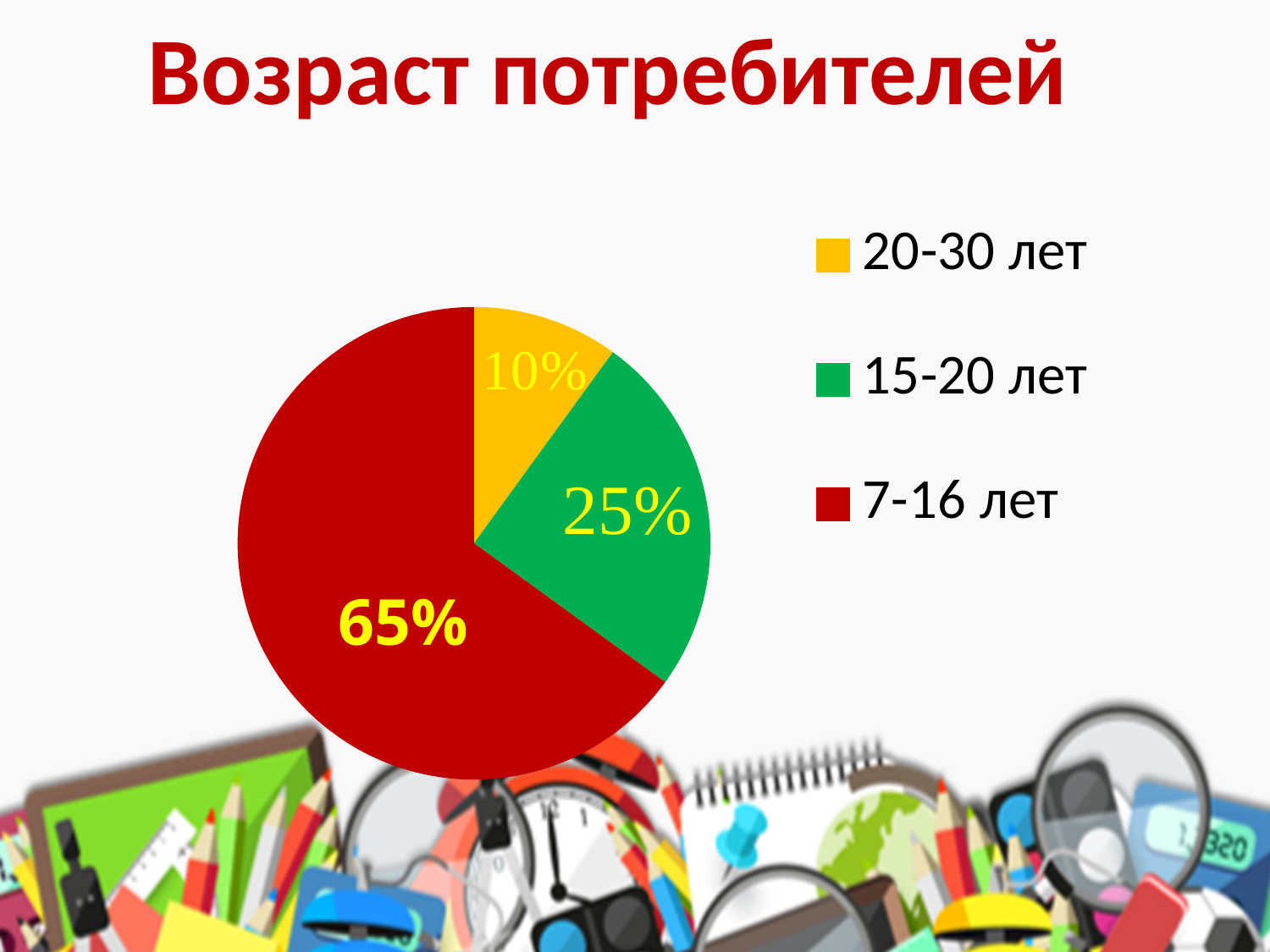
What is the title of the chart? Возраст потребителей What type of chart is shown on the slide? pie chart What colour is the slice for 15-20 лет? green What is the difference between the shares of 7-16 лет and 15-20 лет? 40% What share of the pie does the 7-16 лет slice represent? 65% What share of the pie does the 15-20 лет slice represent? 25% What share of the pie does the 20-30 лет slice represent? 10% Which is larger, the share for 15-20 лет or the share for 20-30 лет? 15-20 лет Which age group has the smallest share of the pie? 20-30 лет Which age group has the largest share of the pie? 7-16 лет How many categories does the pie chart have? 3 What is the difference between the shares of 15-20 лет and 20-30 лет? 15%